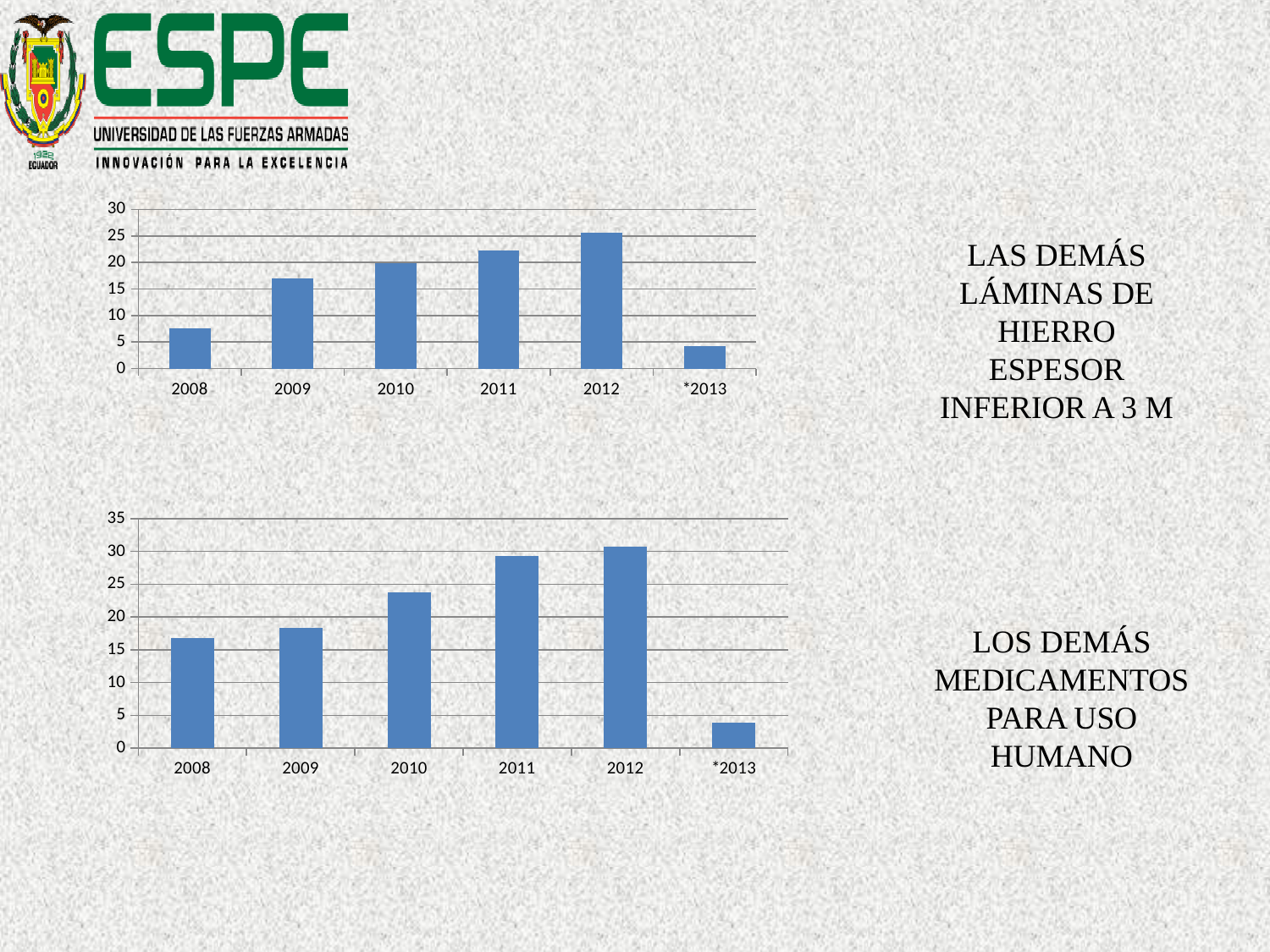
In the top chart (Las demás láminas de hierro espesor inferior a 3 m), which is larger, the value for 2011 or the value for 2009? 2011 In the bottom chart (Los demás medicamentos para uso humano), do the values rise or fall from 2008 to 2012? rise In the top chart (Las demás láminas de hierro espesor inferior a 3 m), which year has the highest bar? 2012 In the bottom chart (Los demás medicamentos para uso humano), is the value for 2011 greater or less than 25? greater In the top chart (Las demás láminas de hierro espesor inferior a 3 m), is the value for 2008 greater or less than 10? less In the top chart (Las demás láminas de hierro espesor inferior a 3 m), which year has the lowest bar? *2013 In the bottom chart (Los demás medicamentos para uso humano), is the value for 2010 greater or less than 25? less In the bottom chart (Los demás medicamentos para uso humano), which year has the lowest bar? *2013 What kind of chart is the bottom chart (Los demás medicamentos para uso humano)? Bar chart How many bars are shown in the top chart (Las demás láminas de hierro espesor inferior a 3 m)? 6 In the bottom chart (Los demás medicamentos para uso humano), which year has the highest bar? 2012